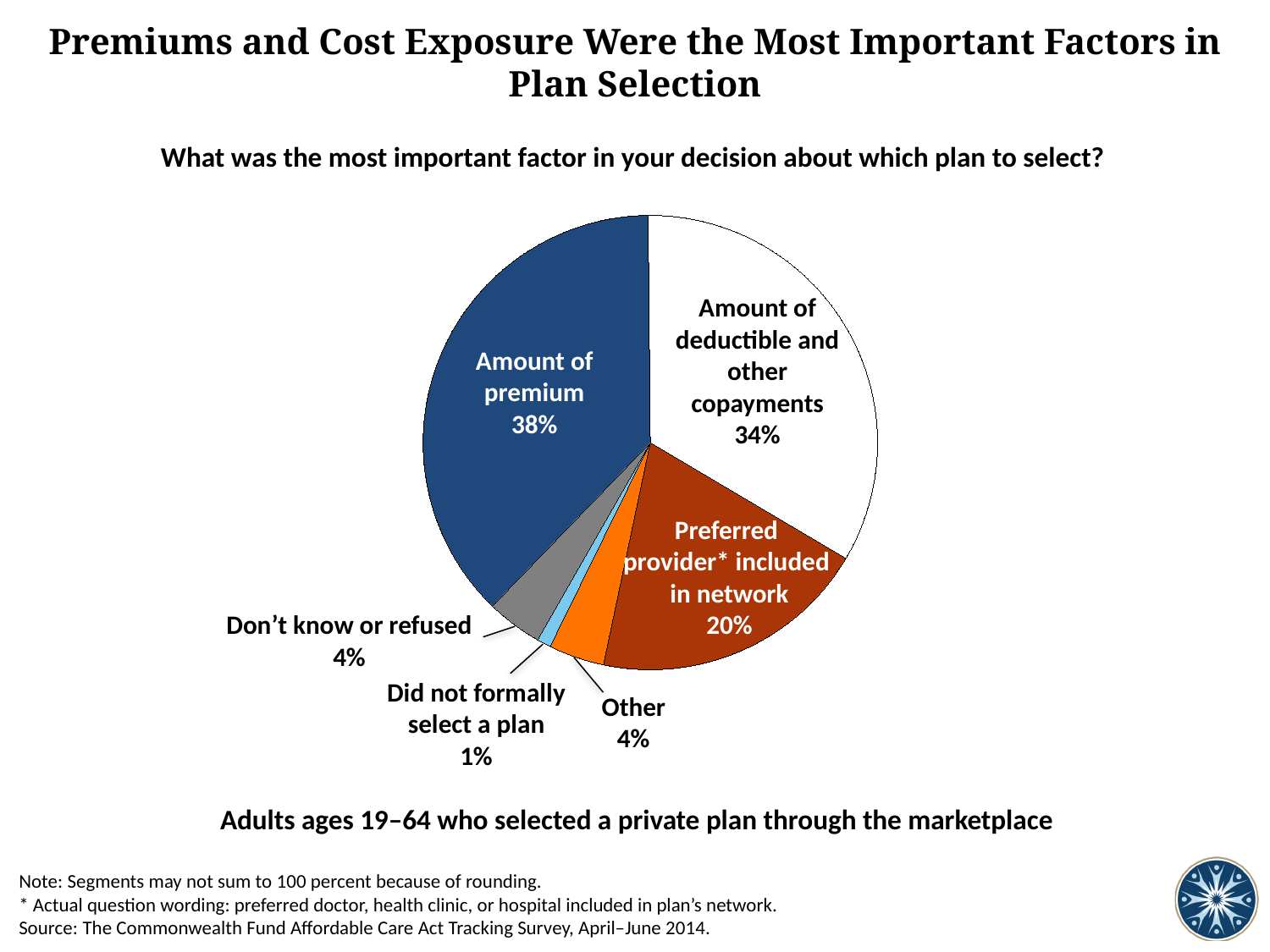
What survey question is the chart based on? What was the most important factor in your decision about which plan to select? What percentage of respondents did not formally select a plan? 1% What share of respondents said the amount of premium was the most important factor? 38% What percentage chose 'Amount of deductible and other copayments' as the most important factor? 34% What share of the pie is 'Preferred provider* included in network'? 20% Which category has the smallest slice of the pie? Did not formally select a plan How many slices does the pie chart have? 6 What percentage answered 'Don't know or refused'? 4% Which factor has the largest slice of the pie? Amount of premium What type of chart is shown on the slide? Pie chart What is the difference in percentage points between 'Amount of premium' and 'Amount of deductible and other copayments'? 4 Which is larger: the share for 'Preferred provider* included in network' or the share for 'Other'? Preferred provider* included in network